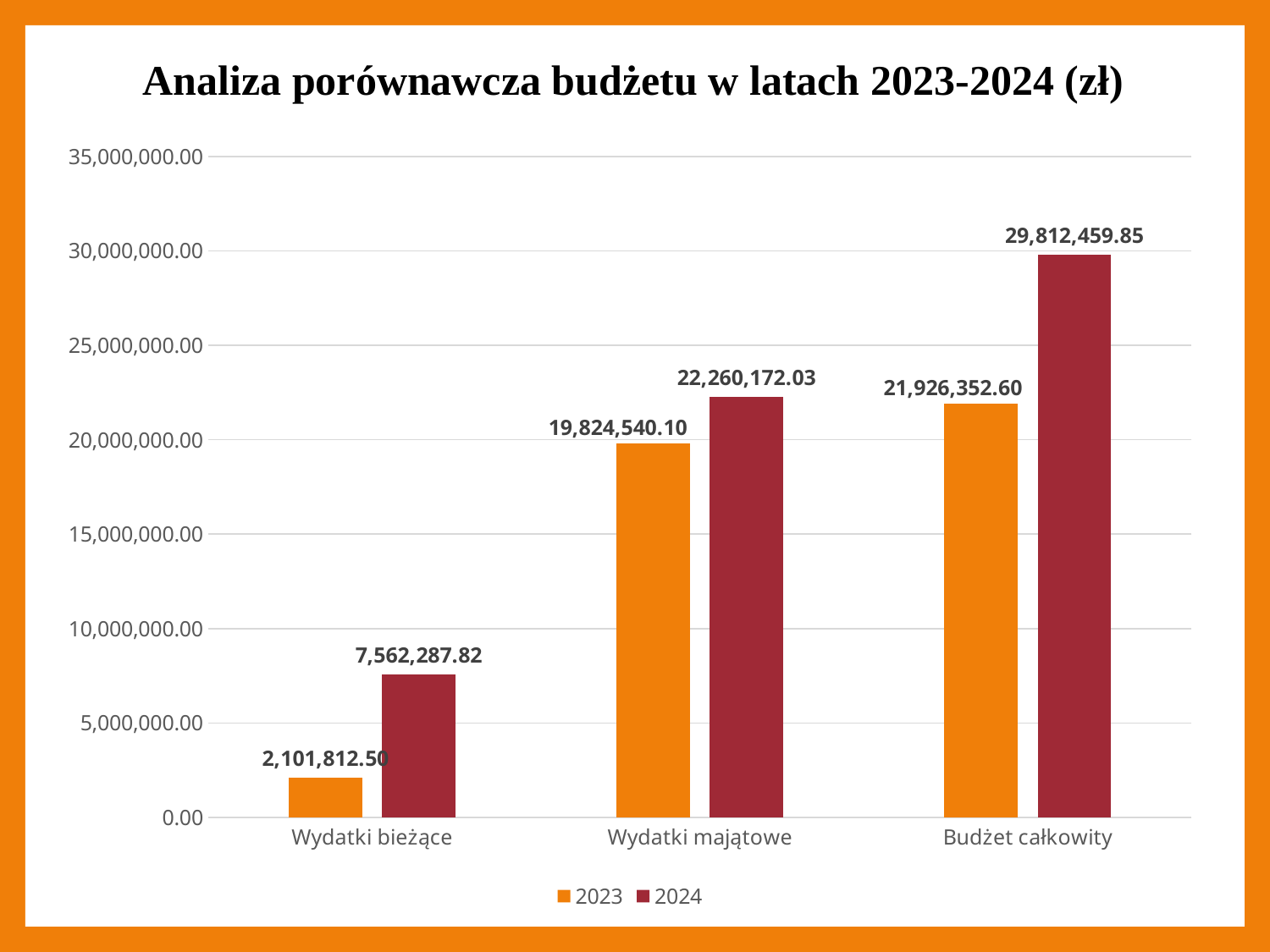
What is the value for Wydatki majątowe in 2023? 19,824,540.10 What is the value for Wydatki bieżące in 2023? 2,101,812.50 Which category has the highest value in the 2024 series? Budżet całkowity What type of chart is shown on the slide? bar chart Which is larger for Wydatki majątowe: the 2023 value or the 2024 value? 2024 Is the 2024 value for Wydatki bieżące greater or less than 10,000,000.00? less What is the value for Budżet całkowity in 2024? 29,812,459.85 How many series does the legend list? 2 What is the difference between the 2024 and 2023 values for Budżet całkowity? 7,886,107.25 What is the difference between the 2024 and 2023 values for Wydatki bieżące? 5,460,475.32 How many categories are shown on the x axis? 3 Which category has the lowest value in the 2023 series? Wydatki bieżące